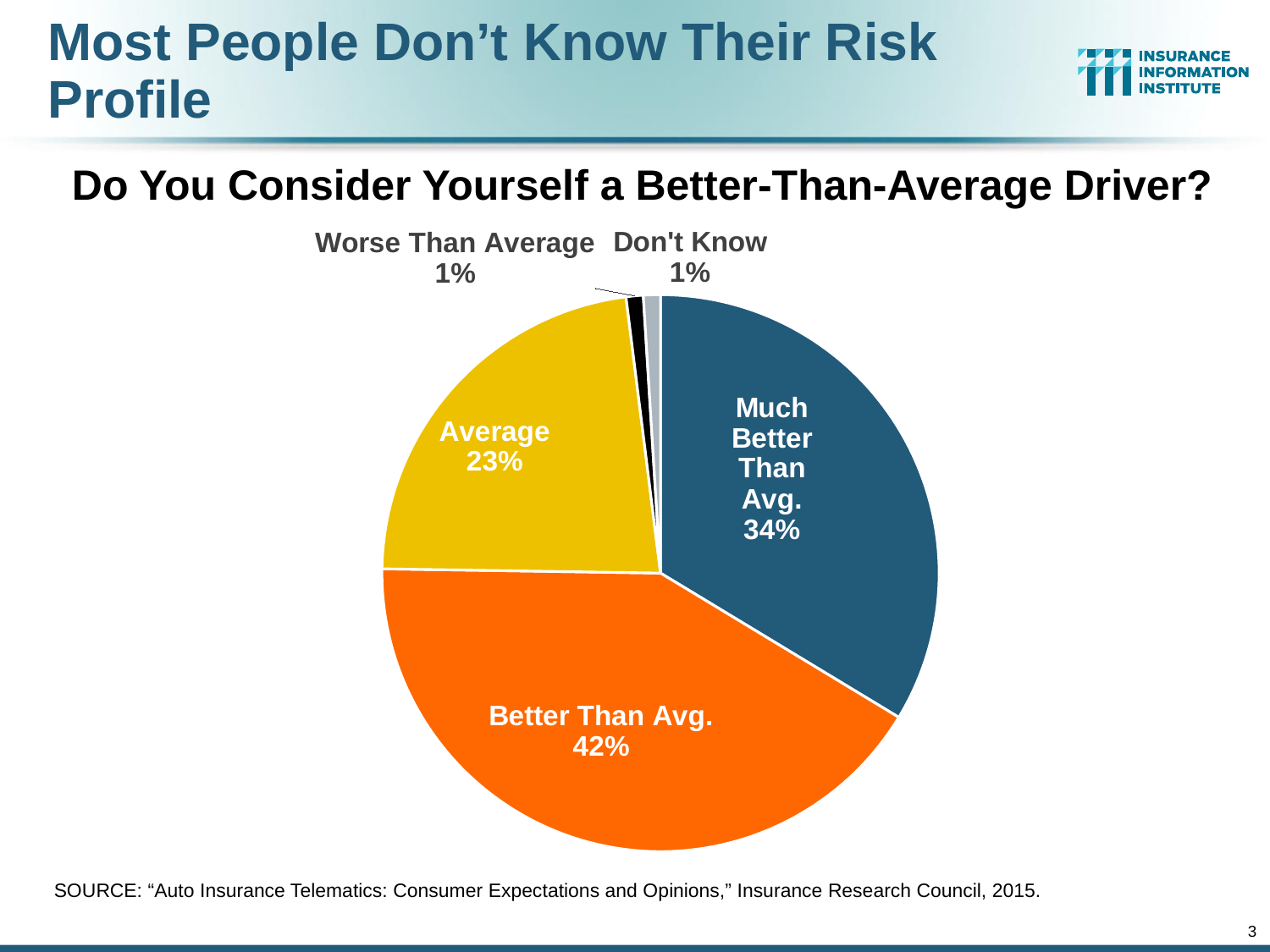
What question does the chart title ask? Do You Consider Yourself a Better-Than-Average Driver? What is the difference in percentage points between Better Than Avg. and Much Better Than Avg.? 8 What share of respondents rated themselves as Average? 23% What is the combined percentage of respondents who consider themselves Better Than Avg. or Much Better Than Avg.? 76% What percentage of respondents consider themselves Better Than Avg. drivers? 42% How many categories are shown in the pie chart? 5 What percentage of respondents consider themselves Much Better Than Avg. drivers? 34% What percentage of respondents answered Worse Than Average? 1% What percentage of respondents answered Don't Know? 1% Which category has the largest slice of the pie? Better Than Avg. What type of chart is shown on the slide? Pie chart Which is larger, the Average slice or the Much Better Than Avg. slice? Much Better Than Avg.